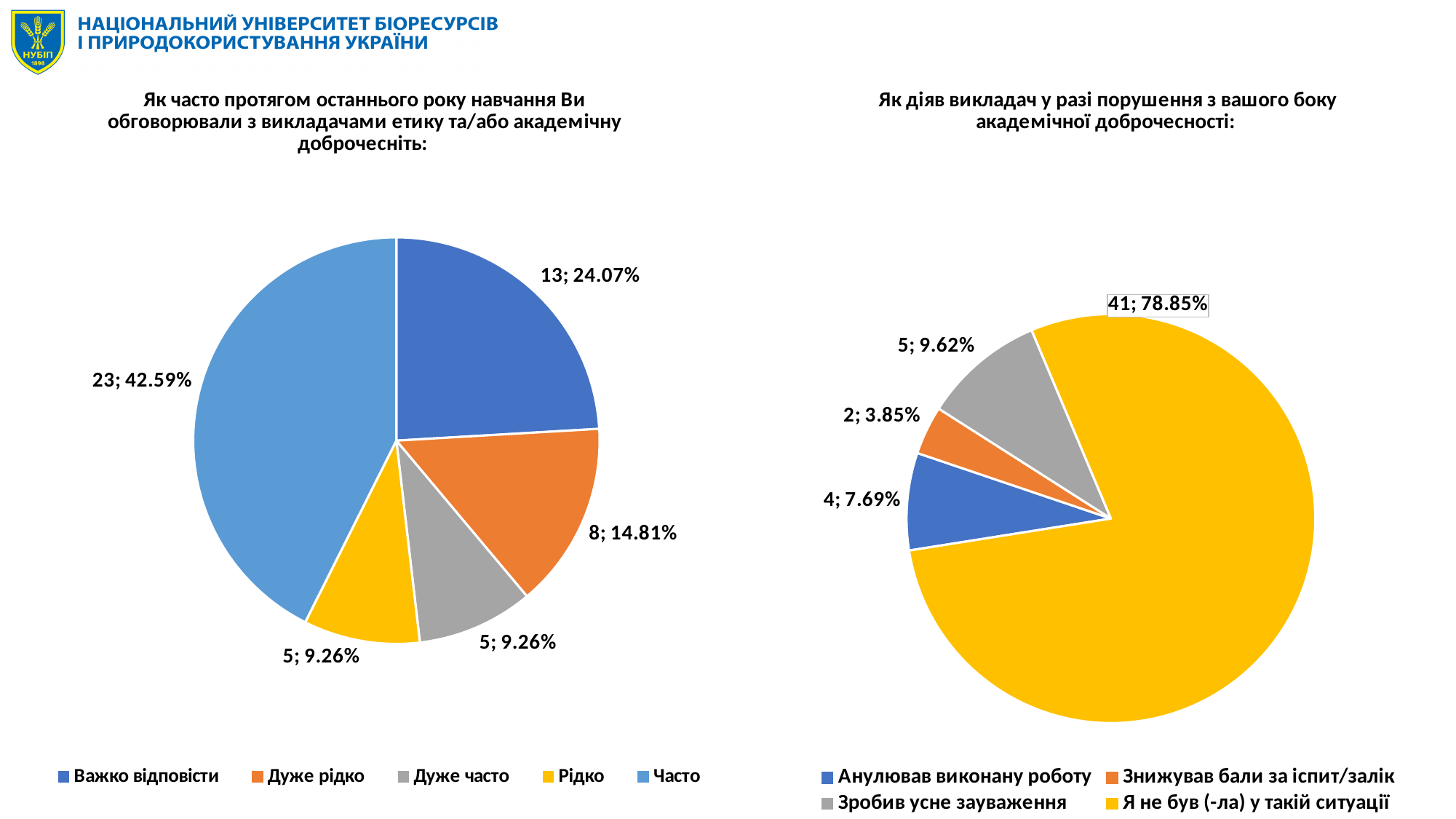
In the left pie chart, what is the count and share for "Часто"? 23; 42.59% In the right pie chart, how many categories does the legend list? 4 In the left pie chart, how many categories does the legend list? 5 In the right pie chart, what share does "Зробив усне зауваження" have? 9.62% In the left pie chart, which category has the largest slice? Часто In the right pie chart, what colour is the slice for "Анулював виконану роботу"? Blue In the left pie chart, what is the difference in count between "Часто" and "Дуже рідко"? 15 What kind of chart is the left chart on the slide? Pie chart In the right pie chart, what is the count and share for "Я не був (-ла) у такій ситуації"? 41; 78.85% In the left pie chart, which is larger: "Важко відповісти" or "Дуже рідко"? Важко відповісти In the left pie chart, what share does "Важко відповісти" have? 24.07% In the right pie chart, which category has the smallest slice? Знижував бали за іспит/залік